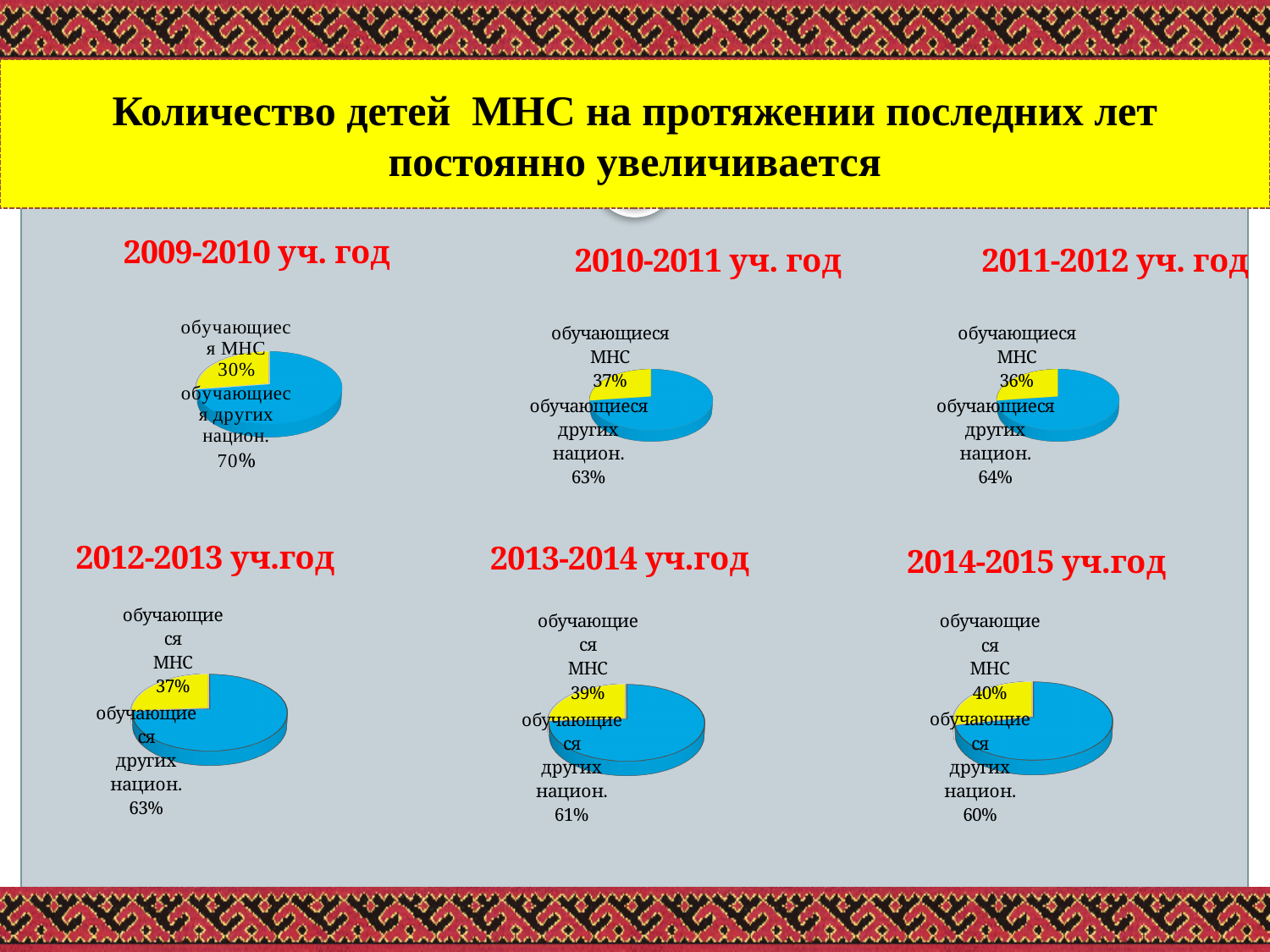
In the 2009-2010 уч. год chart, what is the difference between the share of обучающиеся других национ. and обучающиеся МНС? 40% Which colour represents обучающиеся МНС in the pie charts? Yellow How many slices does the 2011-2012 уч. год pie chart have? 2 How many pie charts are shown on the slide? 6 In the 2011-2012 уч. год chart, what share is labelled for обучающиеся других национ.? 64% In the 2013-2014 уч.год chart, what share is labelled for обучающиеся МНС? 39% In the 2009-2010 уч. год chart, what share is labelled for обучающиеся других национ.? 70% In the 2014-2015 уч.год chart, which slice is larger: обучающиеся МНС or обучающиеся других национ.? обучающиеся других национ. In the 2010-2011 уч. год chart, what share is labelled for обучающиеся МНС? 37% What kind of chart is used for the 2012-2013 уч.год data? Pie chart In the 2009-2010 уч. год chart, what share is labelled for обучающиеся МНС? 30% In the 2014-2015 уч.год chart, what share is labelled for обучающиеся других национ.? 60%